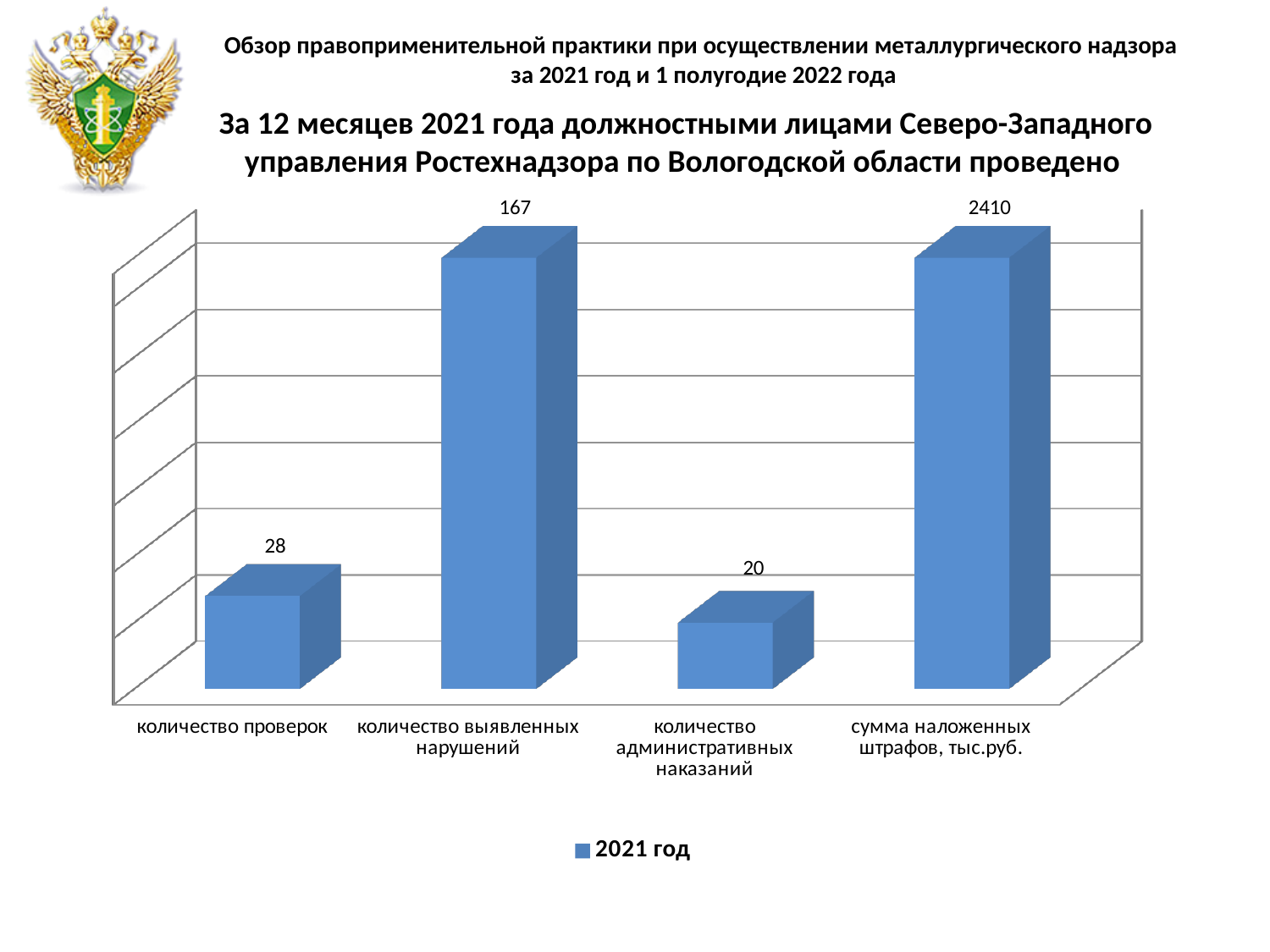
Which is larger: «количество проверок» or «количество административных наказаний»? количество проверок Which category has the highest value? сумма наложенных штрафов, тыс.руб. What is the value for «количество административных наказаний»? 20 What is the difference between «количество проверок» and «количество административных наказаний»? 8 What is the value for «количество проверок»? 28 How many categories are shown on the chart? 4 What is the value for «количество выявленных нарушений»? 167 What is the difference between «количество выявленных нарушений» and «количество проверок»? 139 What is the value for «сумма наложенных штрафов, тыс.руб.»? 2410 Which category has the lowest value? количество административных наказаний How many series does the legend list? 1 What kind of chart is shown on the slide? bar chart